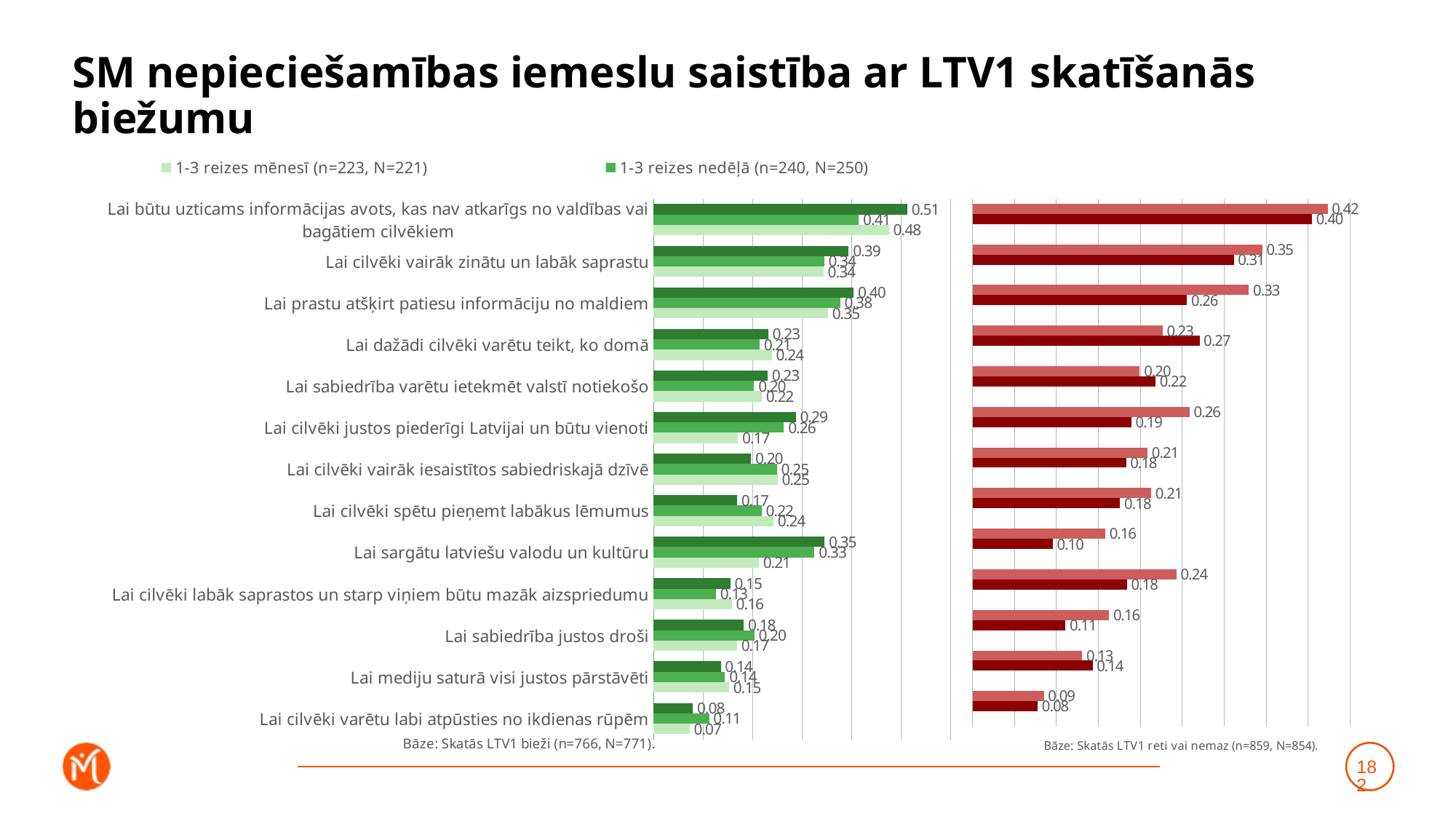
What kind of chart is shown on the left side of the slide? bar chart On the right (red) chart, what is the difference between the top and bottom bars for 'Lai sargātu latviešu valodu un kultūru'? 0.06 On the left chart, what is the '1-3 reizes mēnesī' value for 'Lai būtu uzticams informācijas avots, kas nav atkarīgs no valdības vai bagātiem cilvēkiem'? 0.48 On the left chart, what is the '1-3 reizes mēnesī' value for 'Lai cilvēki varētu labi atpūsties no ikdienas rūpēm'? 0.07 On the left chart, which category has the lowest '1-3 reizes mēnesī' value? Lai cilvēki varētu labi atpūsties no ikdienas rūpēm On the left chart, what is the difference between the '1-3 reizes mēnesī' values for 'Lai būtu uzticams informācijas avots...' and 'Lai cilvēki vairāk zinātu un labāk saprastu'? 0.14 On the left chart, which category has the highest '1-3 reizes mēnesī' value? Lai būtu uzticams informācijas avots, kas nav atkarīgs no valdības vai bagātiem cilvēkiem On the right (red) chart, what is the value of the top (lighter red) bar for 'Lai sargātu latviešu valodu un kultūru'? 0.16 On the right (red) chart, for 'Lai dažādi cilvēki varētu teikt, ko domā', which bar is larger: the top (lighter red) bar or the bottom (dark red) bar? the bottom (dark red) bar How many series does the legend at the top of the slide list? 2 How many categories (reasons) are listed on the left chart? 13 What base note is printed under the right (red) chart? Bāze: Skatās LTV1 reti vai nemaz (n=859, N=854).